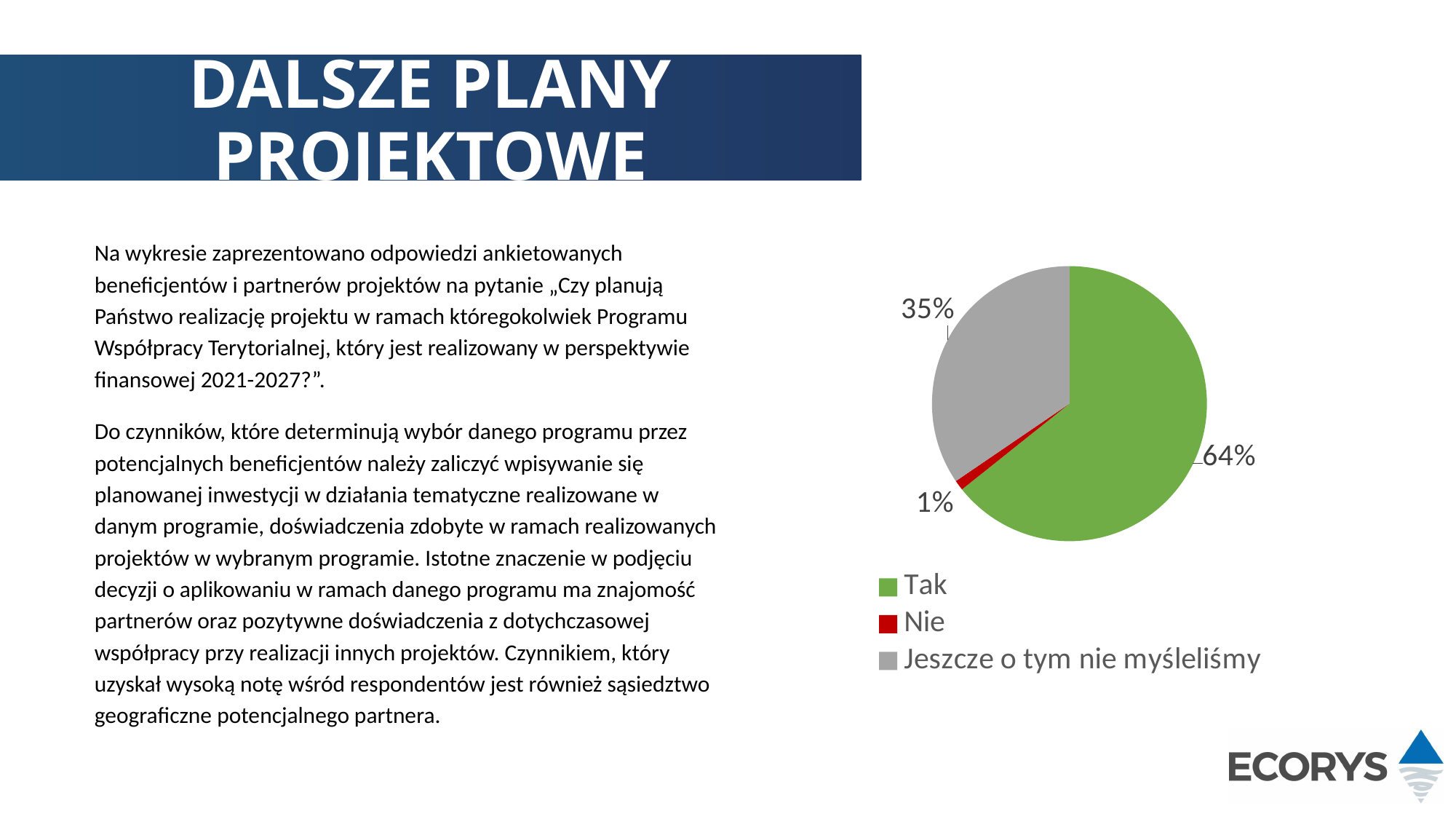
What colour is the slice for "Nie"? red What share of the pie does "Tak" represent? 64% Which category has the largest slice of the pie? Tak How many entries does the legend list? 3 Which category has the smallest slice of the pie? Nie How many categories does the pie chart have? 3 Which is larger, the share for "Nie" or the share for "Jeszcze o tym nie myśleliśmy"? Jeszcze o tym nie myśleliśmy What is the difference in percentage points between "Tak" and "Jeszcze o tym nie myśleliśmy"? 29 What share of the pie does "Nie" represent? 1% What colour is the slice for "Tak"? green What share of the pie does "Jeszcze o tym nie myśleliśmy" represent? 35% What kind of chart is shown on the slide? pie chart